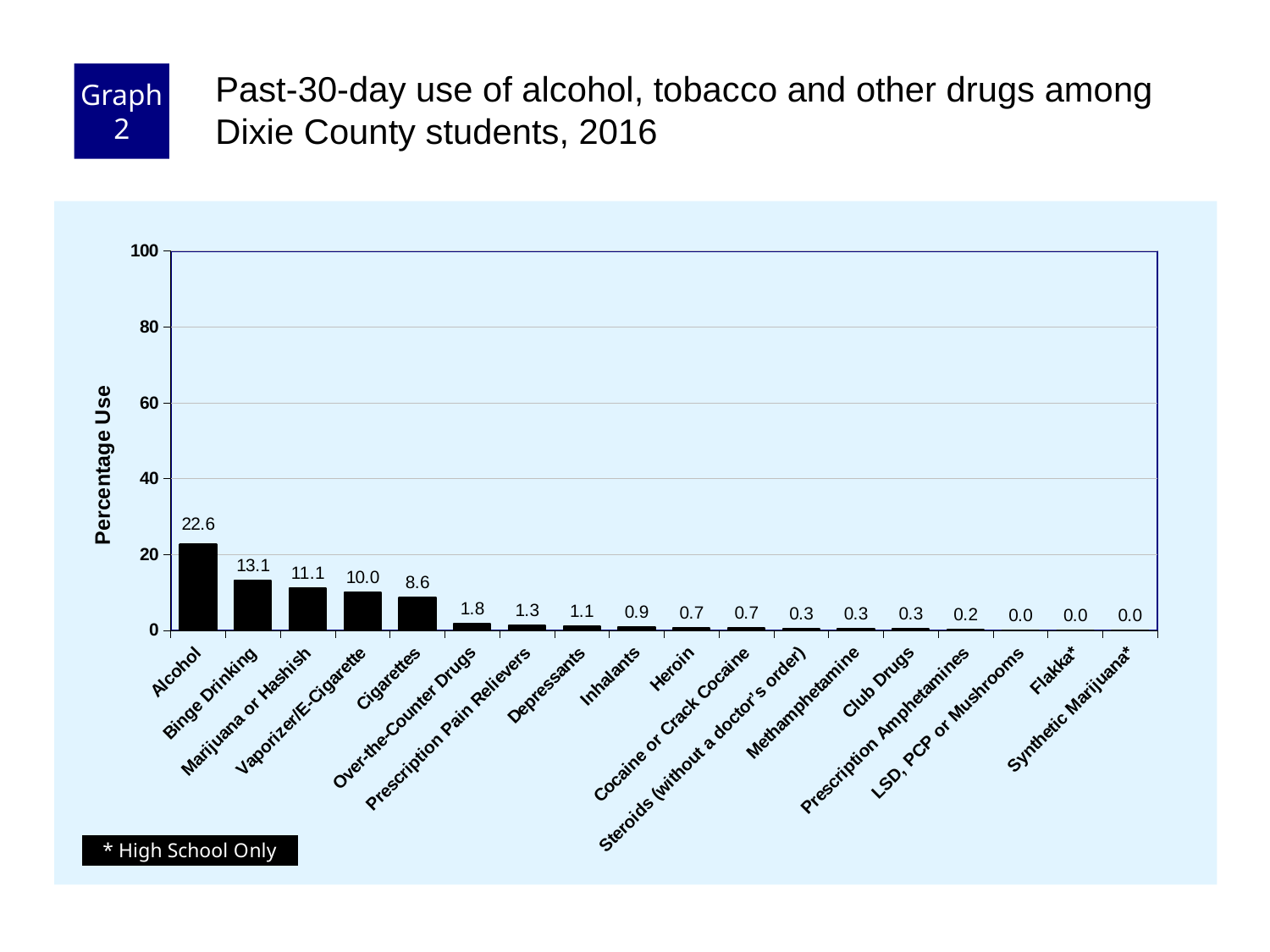
What is the label on the y axis? Percentage Use Which is larger, the value for Binge Drinking or the value for Marijuana or Hashish? Binge Drinking What is the value for Alcohol? 22.6 What is the difference between the values for Marijuana or Hashish and Vaporizer/E-Cigarette? 1.1 How many categories are shown on the x axis? 18 What is the value for Cigarettes? 8.6 What kind of chart is shown on the slide? bar chart What is the difference between the values for Alcohol and Binge Drinking? 9.5 Is the value for Alcohol greater or less than 20? greater What is the value for Prescription Amphetamines? 0.2 Which category has the highest value? Alcohol Do the values rise or fall moving from left to right along the x axis? fall